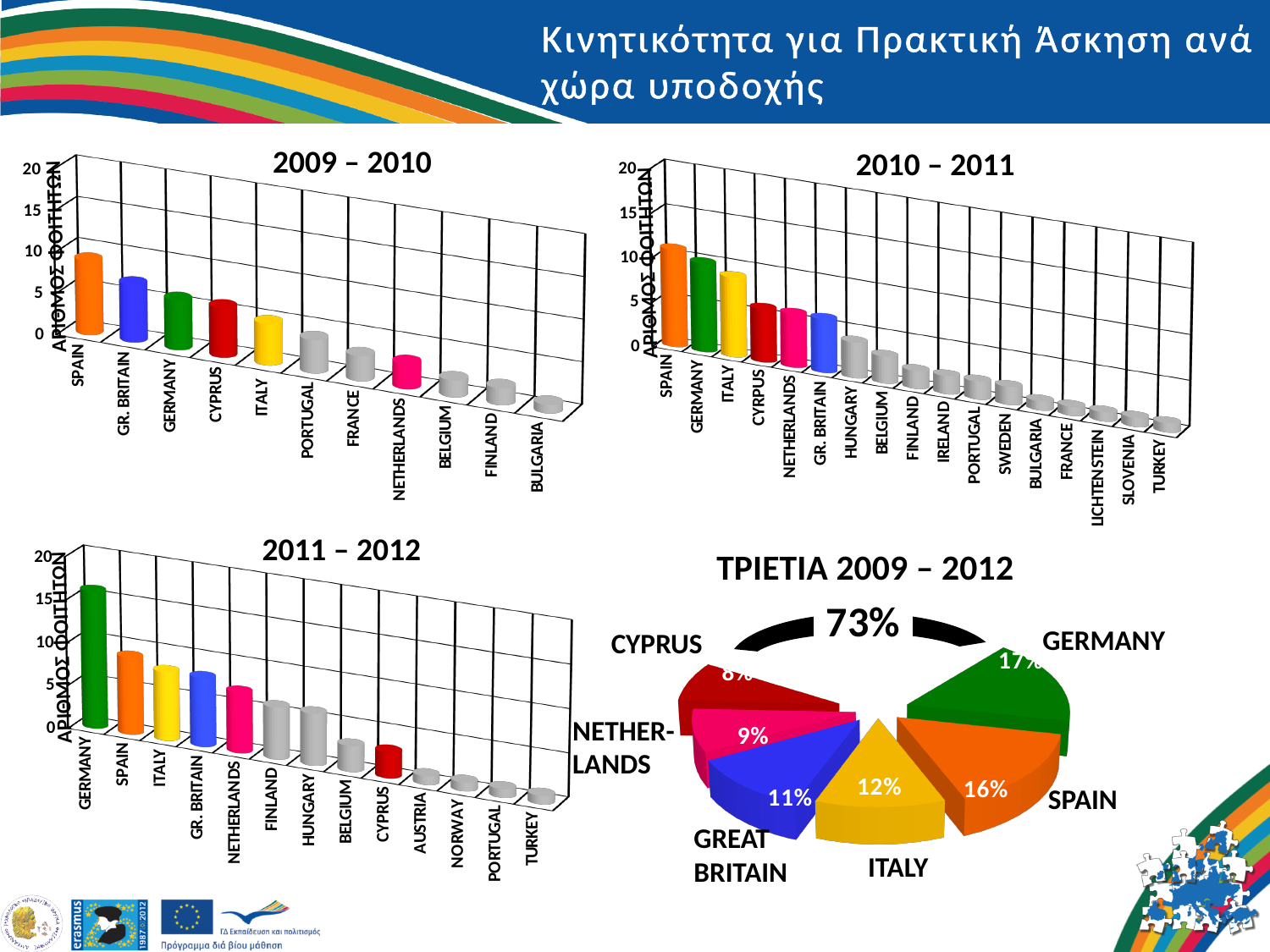
In the 2009 – 2010 chart, which country has the highest value? SPAIN In the 2011 – 2012 chart, which country has the highest value? GERMANY In the 2011 – 2012 chart, do the values rise or fall from left to right along the x axis? fall How many countries are shown in the 2009 – 2010 chart? 11 How many countries are shown in the 2010 – 2011 chart? 17 In the 2009 – 2010 chart, is the value for SPAIN greater or less than 5? greater In the ΤΡΙΕΤΙΑ 2009 – 2012 pie chart, what share does SPAIN have? 16% What kind of chart is the 2009 – 2010 chart? bar chart In the ΤΡΙΕΤΙΑ 2009 – 2012 pie chart, which is larger, GREAT BRITAIN or NETHERLANDS? GREAT BRITAIN In the 2011 – 2012 chart, is the value for GERMANY greater or less than 10? greater In the ΤΡΙΕΤΙΑ 2009 – 2012 pie chart, what is the difference between the shares of SPAIN and ITALY? 4%